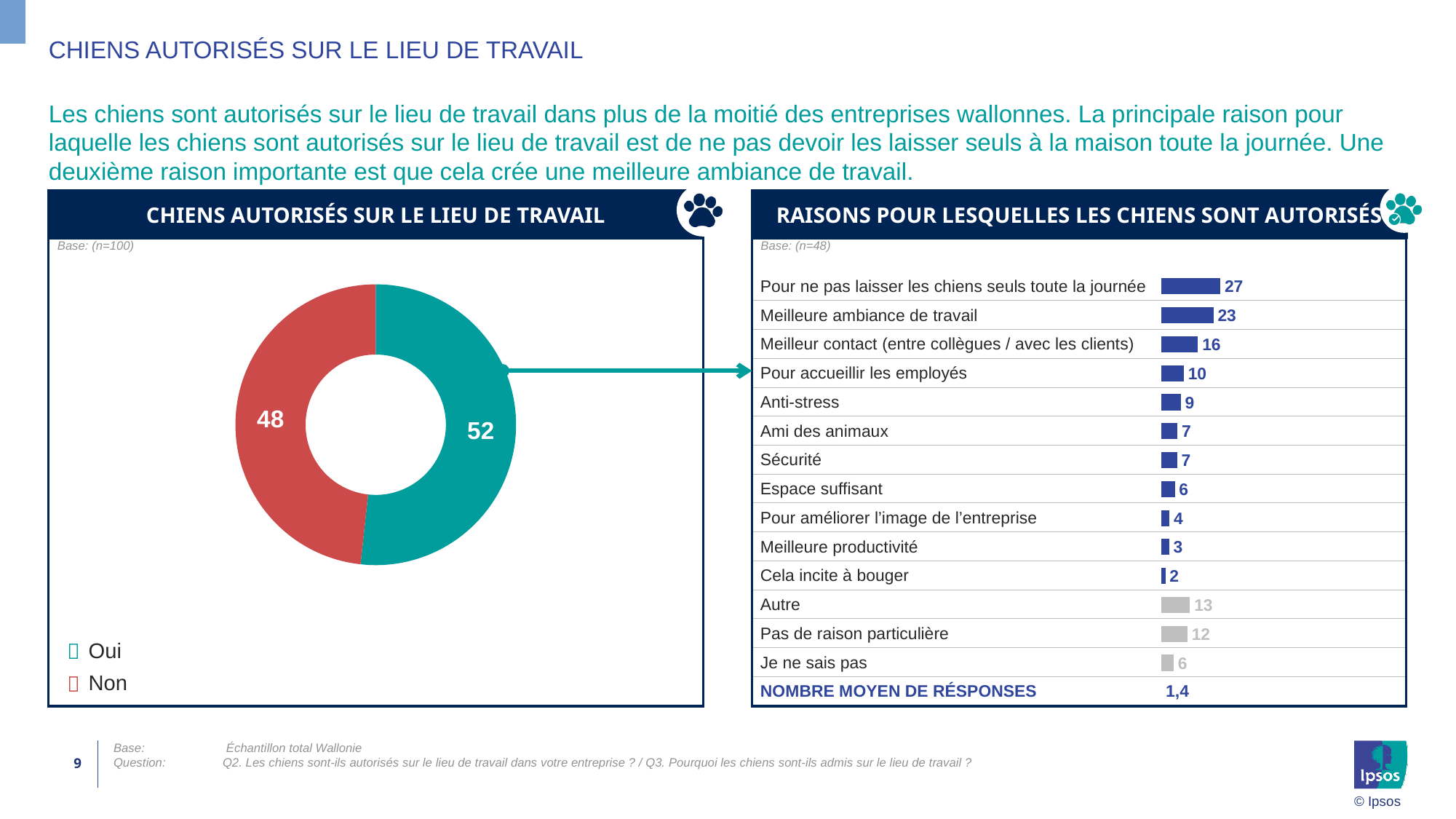
In the chart 'CHIENS AUTORISÉS SUR LE LIEU DE TRAVAIL', what is the value for 'Non'? 48 In the chart 'RAISONS POUR LESQUELLES LES CHIENS SONT AUTORISÉS', what is the 'NOMBRE MOYEN DE RÉSPONSES'? 1,4 In the chart 'RAISONS POUR LESQUELLES LES CHIENS SONT AUTORISÉS', which reason has the highest value? Pour ne pas laisser les chiens seuls toute la journée In the chart 'RAISONS POUR LESQUELLES LES CHIENS SONT AUTORISÉS', what is the value for 'Pour accueillir les employés'? 10 In the chart 'CHIENS AUTORISÉS SUR LE LIEU DE TRAVAIL', which is larger, 'Oui' or 'Non'? Oui In the chart 'RAISONS POUR LESQUELLES LES CHIENS SONT AUTORISÉS', what is the value for 'Meilleure ambiance de travail'? 23 In the chart 'CHIENS AUTORISÉS SUR LE LIEU DE TRAVAIL', what is the value for 'Oui'? 52 In the chart 'RAISONS POUR LESQUELLES LES CHIENS SONT AUTORISÉS', what is the difference between 'Pour ne pas laisser les chiens seuls toute la journée' and 'Meilleur contact (entre collègues / avec les clients)'? 11 In the chart 'CHIENS AUTORISÉS SUR LE LIEU DE TRAVAIL', what is the difference between 'Oui' and 'Non'? 4 What kind of chart is 'RAISONS POUR LESQUELLES LES CHIENS SONT AUTORISÉS'? Bar chart What kind of chart is 'CHIENS AUTORISÉS SUR LE LIEU DE TRAVAIL'? Donut (pie) chart In the chart 'RAISONS POUR LESQUELLES LES CHIENS SONT AUTORISÉS', which reason has the lowest value? Cela incite à bouger